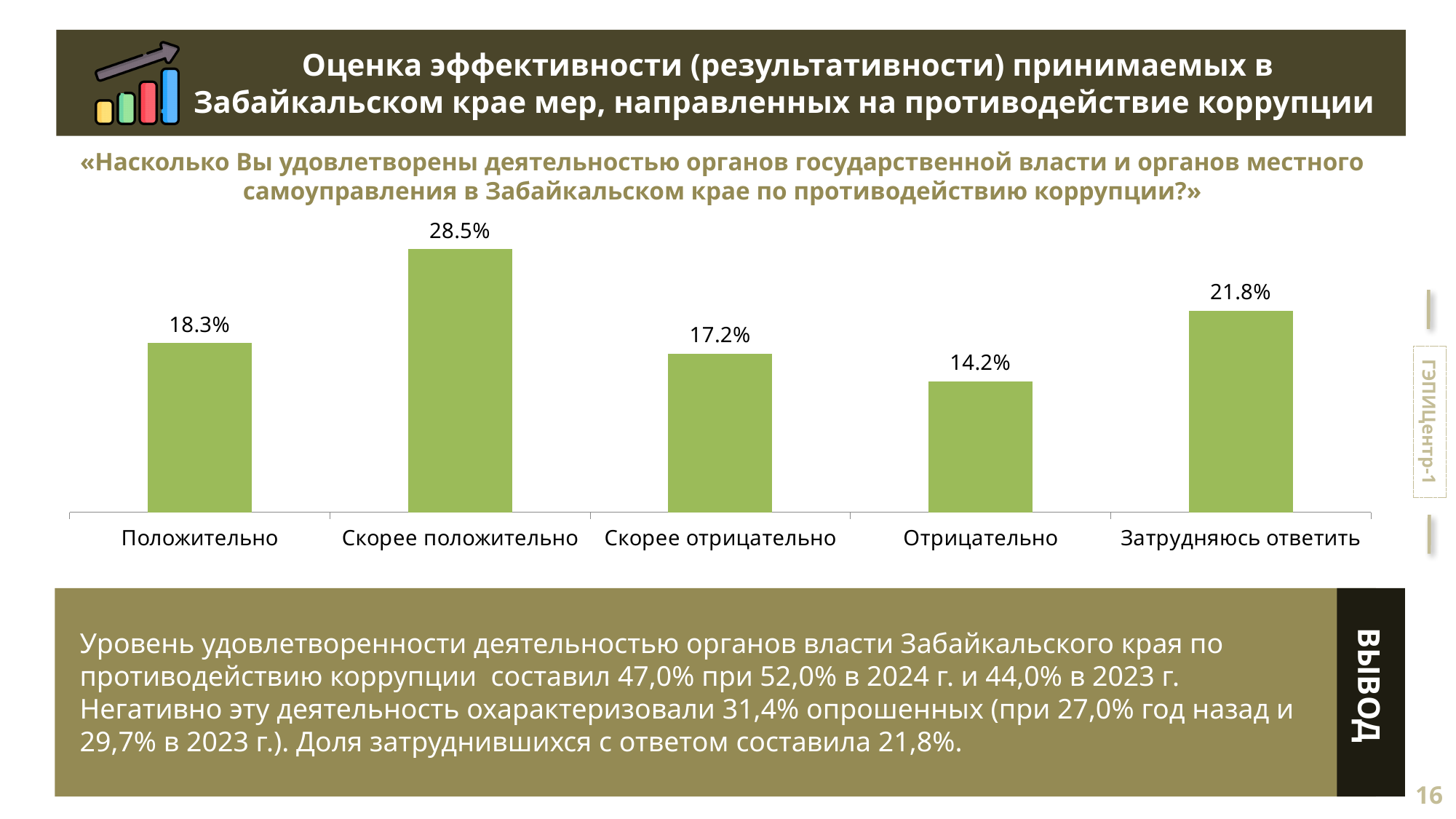
Which is larger: the value for «Затрудняюсь ответить» or the value for «Скорее отрицательно»? Затрудняюсь ответить Which category has the lowest value? Отрицательно What is the value for «Положительно»? 18.3% What is the combined value of «Положительно» and «Скорее положительно»? 46.8% Which category has the highest value? Скорее положительно What is the value for «Затрудняюсь ответить»? 21.8% What is the value for «Скорее отрицательно»? 17.2% What kind of chart is shown on the slide? Bar chart What is the value for «Отрицательно»? 14.2% What is the difference between the values for «Скорее положительно» and «Положительно»? 10.2% How many categories are shown in the chart? 5 What is the value for «Скорее положительно»? 28.5%